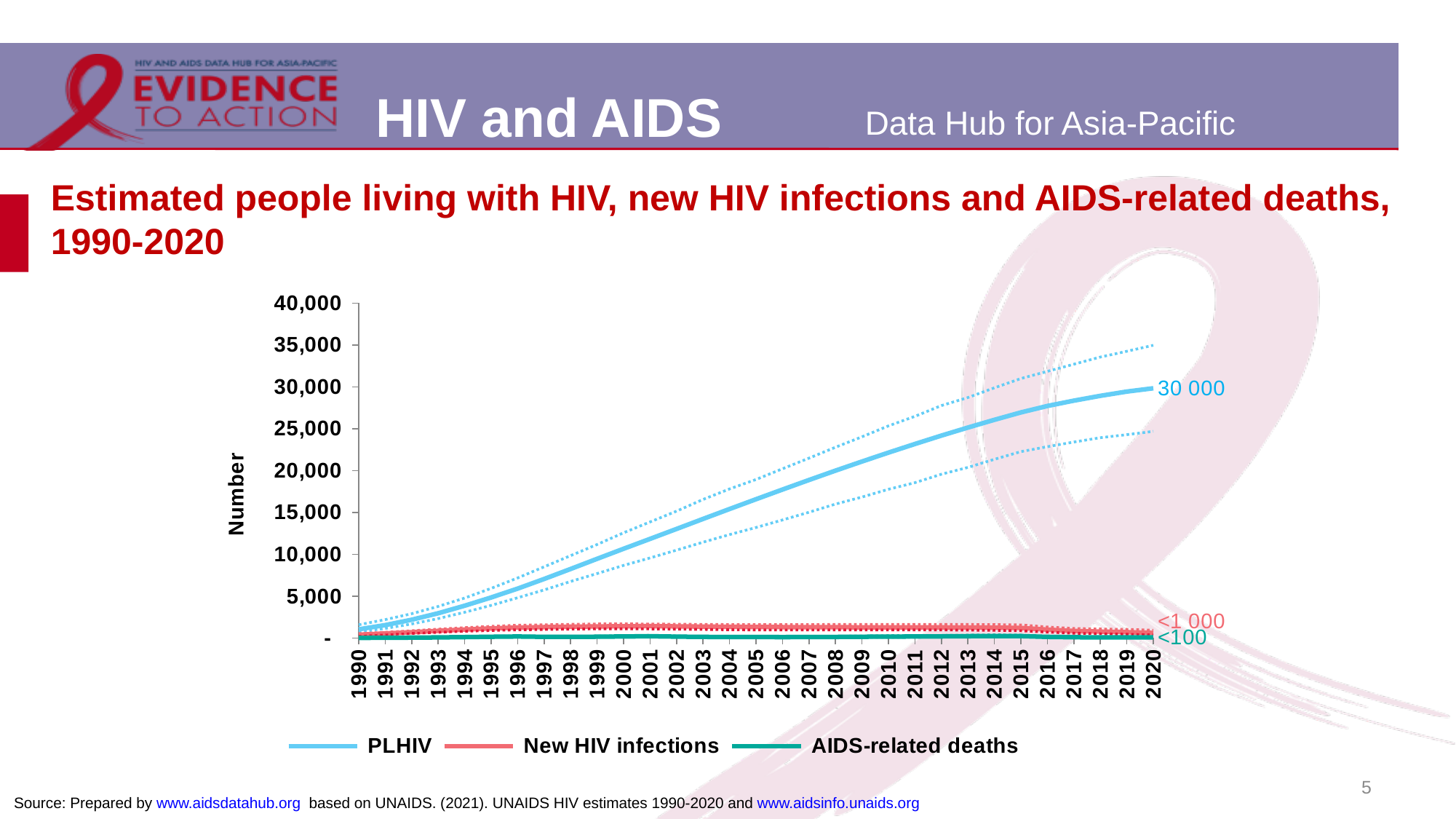
What is the labelled value of New HIV infections in 2020? <1 000 What is the labelled value of AIDS-related deaths in 2020? <100 What is the labelled value of PLHIV in 2020? 30 000 What is the title of the vertical axis? Number Which series has the lowest value in 2020? AIDS-related deaths Which series has the highest value in 2020? PLHIV Does the PLHIV line rise or fall from 1990 to 2020? Rises How many series does the legend list? 3 What kind of chart is shown on the slide? Line chart In 2020, which is larger: PLHIV or New HIV infections? PLHIV Is the value for PLHIV in 2005 greater or less than 10,000? greater Is the value for PLHIV in 1995 greater or less than 10,000? less